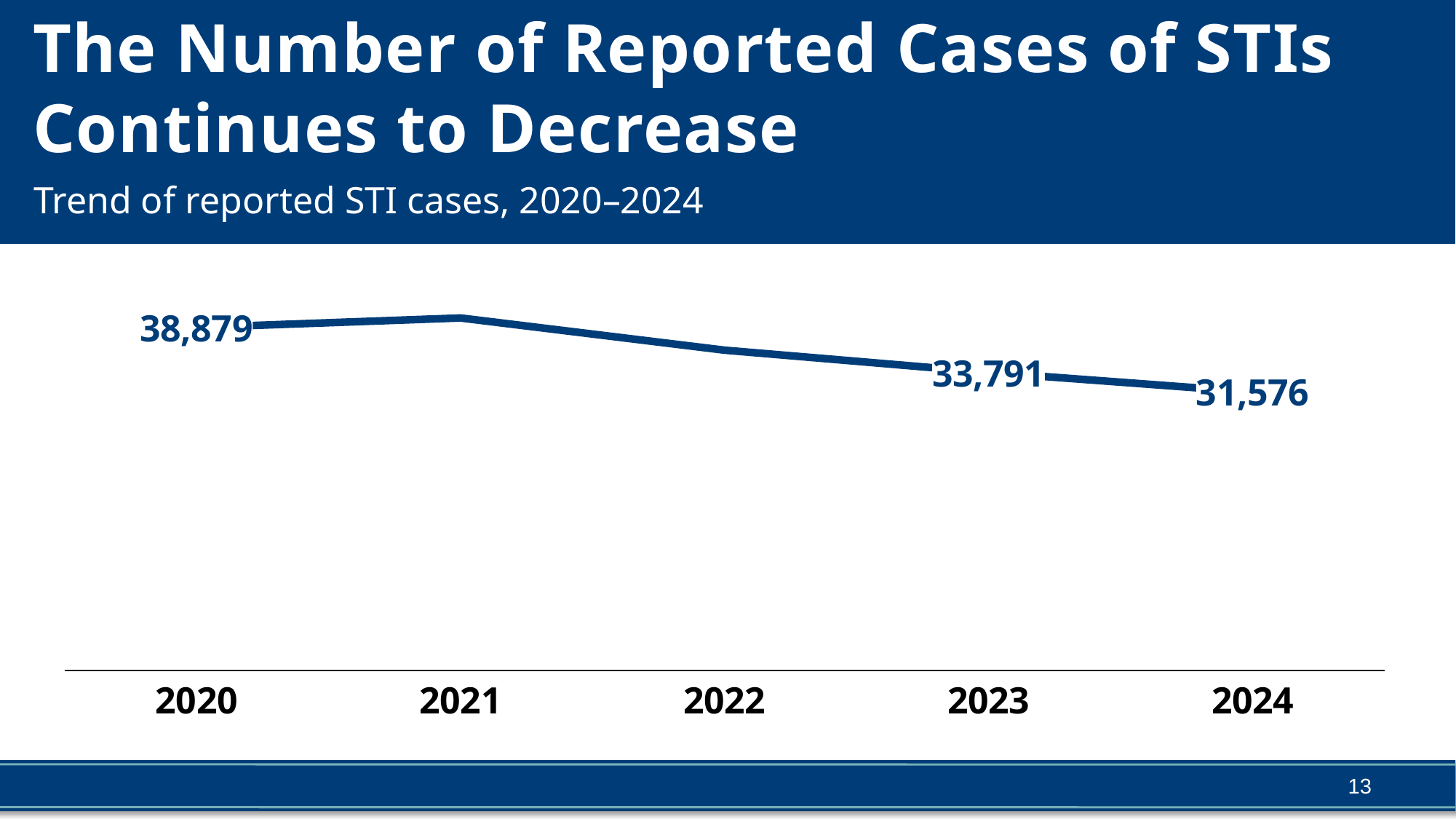
How many years are shown on the x axis of the chart? 5 Do the reported STI cases rise or fall from 2021 to 2024? fall What is the number of reported STI cases in 2024? 31,576 What is the difference between the reported STI cases in 2023 and 2024? 2,215 What is the number of reported STI cases in 2020? 38,879 What is the difference between the reported STI cases in 2020 and 2023? 5,088 Which year has more reported STI cases, 2020 or 2024? 2020 Which year has the lowest number of reported STI cases? 2024 What is the number of reported STI cases in 2023? 33,791 What kind of chart is shown on the slide? line chart Which year has more reported STI cases, 2023 or 2024? 2023 What is the difference between the reported STI cases in 2020 and 2024? 7,303